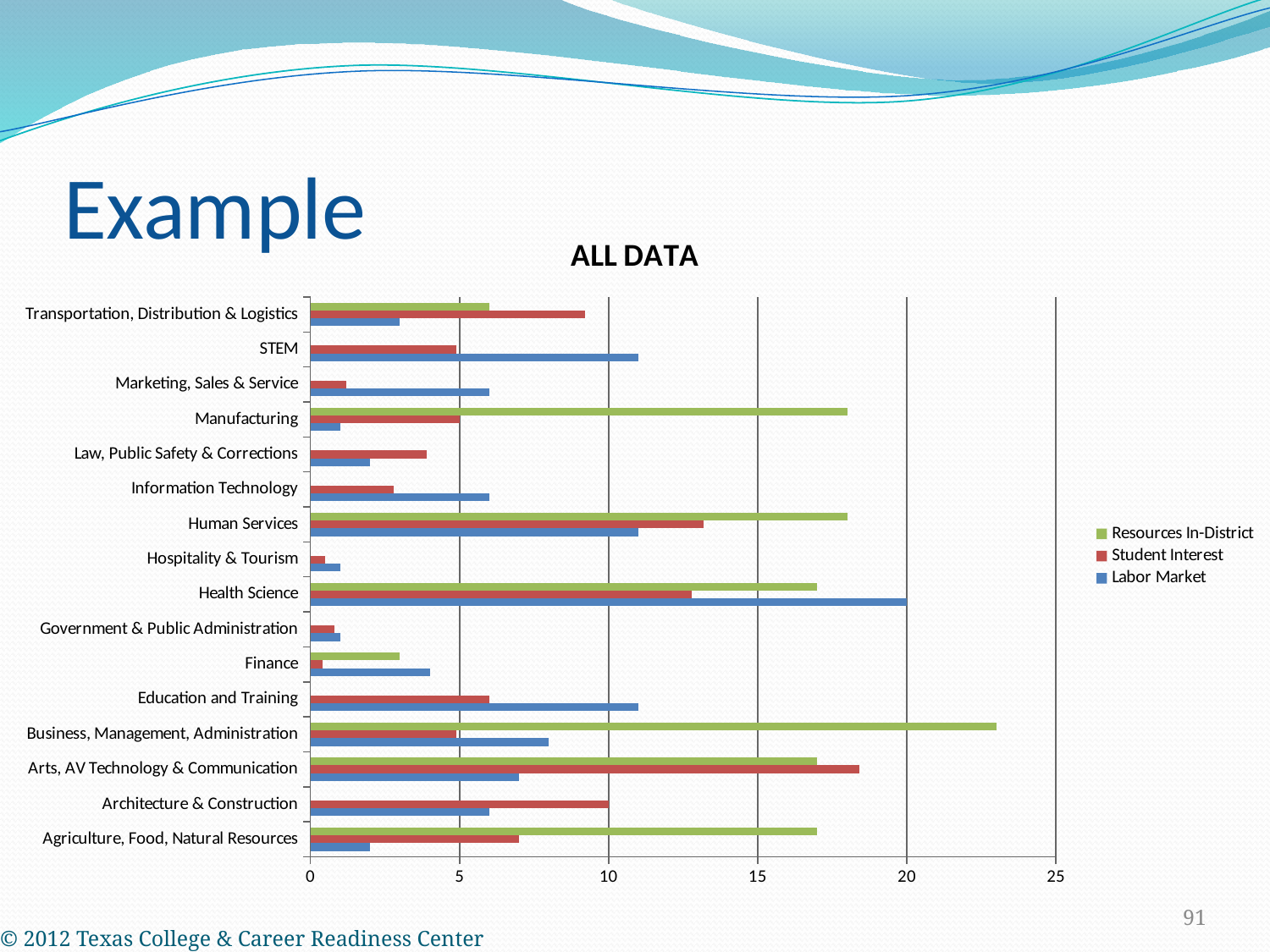
How many categories are shown on the vertical axis of the chart? 16 Is the Labor Market value for STEM greater or less than 10? greater For Human Services, which is larger: Resources In-District or Labor Market? Resources In-District Is the Labor Market value for Hospitality & Tourism greater or less than 5? less How many series does the legend list? 3 Which category has the highest Labor Market value? Health Science Which category has the highest Student Interest value? Arts, AV Technology & Communication Is the Resources In-District value for Manufacturing greater or less than 15? greater What is the title of the chart? ALL DATA For Transportation, Distribution & Logistics, which is larger: Student Interest or Labor Market? Student Interest What kind of chart is shown on the slide? bar chart Which category has the highest Resources In-District value? Business, Management, Administration